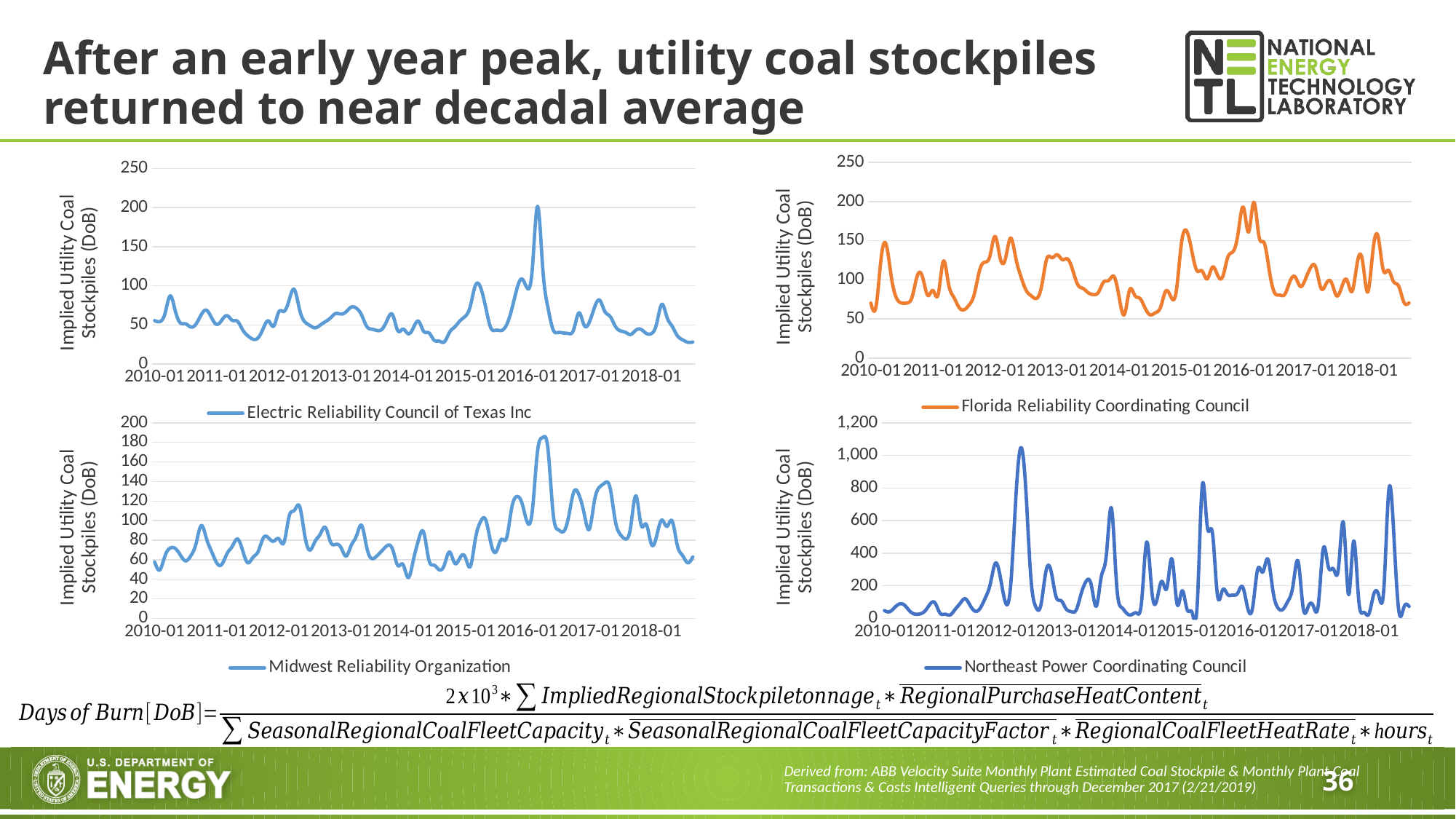
In the Florida Reliability Coordinating Council chart, is the value at 2010-01 greater or less than 100? less In the Northeast Power Coordinating Council chart, is the peak value around 2012 greater or less than 800? greater How many series does the legend of the Florida Reliability Coordinating Council chart list? 1 How many charts are shown on the slide? 4 What is the y-axis label of the Midwest Reliability Organization chart? Implied Utility Coal Stockpiles (DoB) In the Midwest Reliability Organization chart, is the peak value around 2016 greater or less than 160? greater What kind of chart is the Electric Reliability Council of Texas Inc chart? line chart What is the legend entry of the bottom-right chart? Northeast Power Coordinating Council